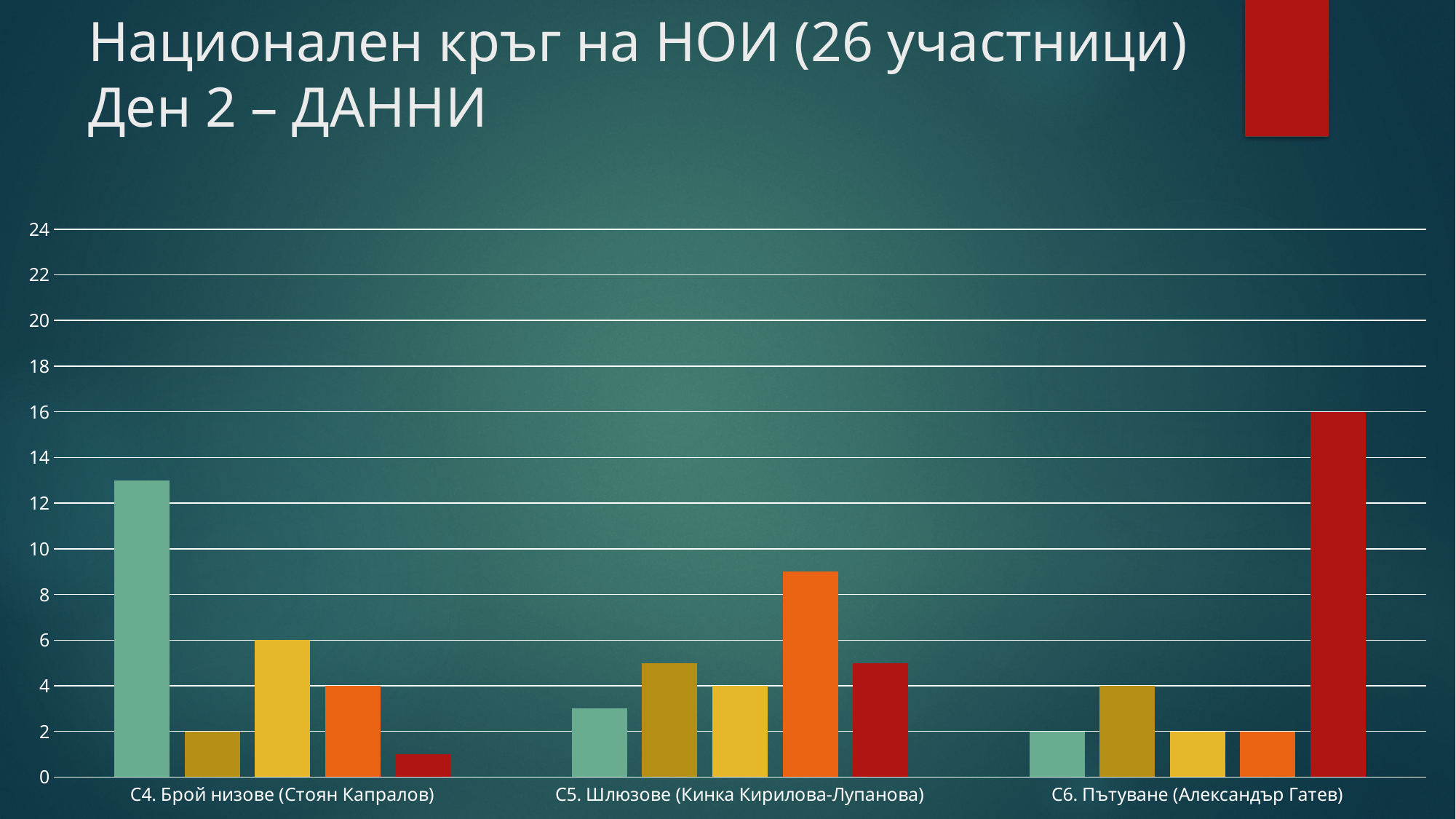
What is the value of the yellow bar in the category С4. Брой низове (Стоян Капралов)? 6 What is the value of the orange bar in the category С4. Брой низове (Стоян Капралов)? 4 What kind of chart is shown on the slide? bar chart How many categories are shown on the x axis of the chart? 3 Is the value of the red bar in the category С4. Брой низове (Стоян Капралов) greater or less than 2? less Which category contains the tallest bar in the chart? С6. Пътуване (Александър Гатев) What is the value of the yellow bar in the category С5. Шлюзове (Кинка Кирилова-Лупанова)? 4 Which is larger: the red bar in С6. Пътуване (Александър Гатев) or the light green bar in С4. Брой низове (Стоян Капралов)? the red bar in С6. Пътуване (Александър Гатев) Is the value of the first (light green) bar in the category С4. Брой низове (Стоян Капралов) greater or less than 12? greater What is the difference between the red bar in С6. Пътуване (Александър Гатев) and the yellow bar in С4. Брой низове (Стоян Капралов)? 10 Is the value of the orange bar in the category С5. Шлюзове (Кинка Кирилова-Лупанова) greater or less than 8? greater What is the value of the tallest (red) bar in the category С6. Пътуване (Александър Гатев)? 16